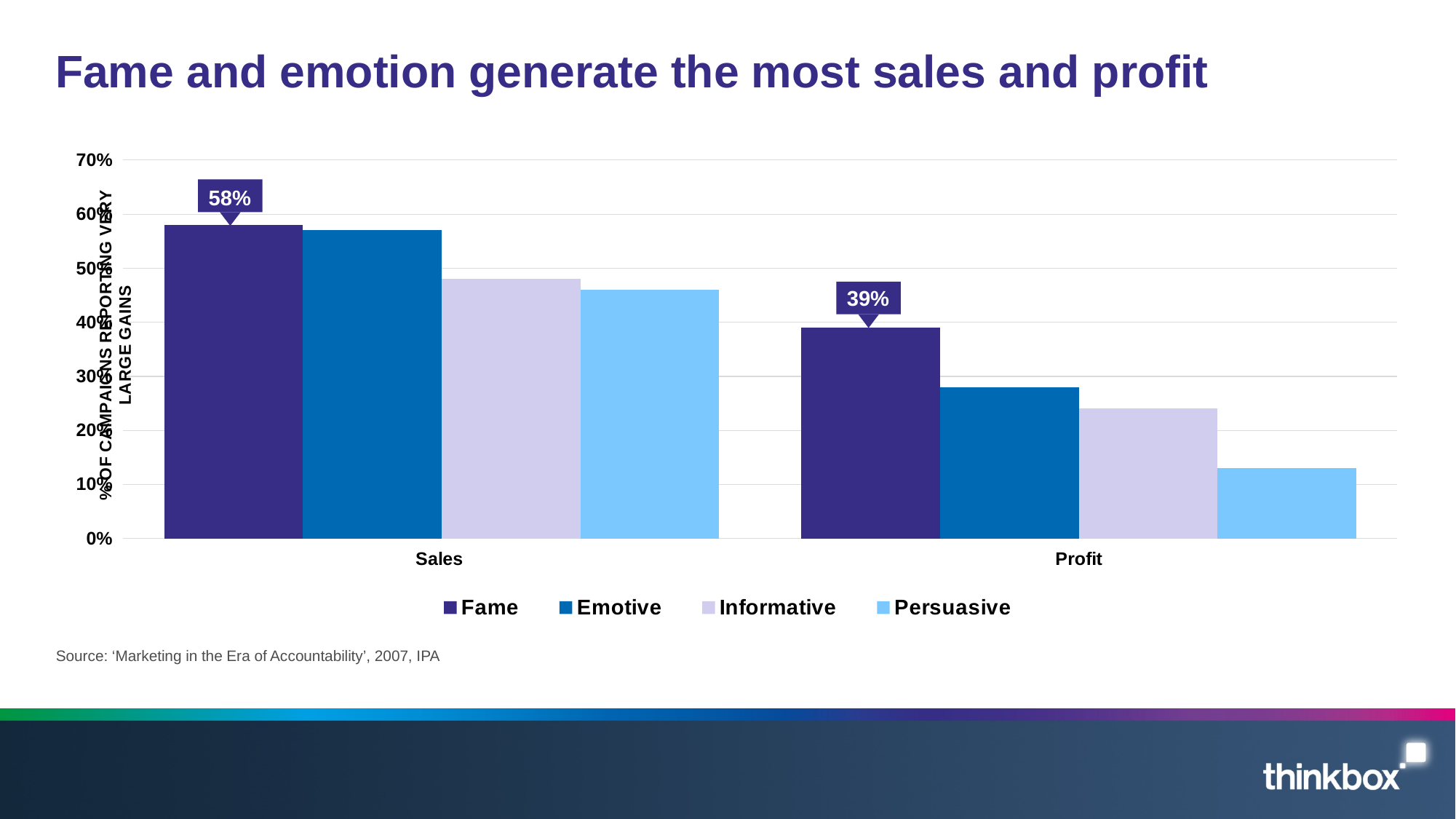
What is the difference between the Fame value for Sales and the Fame value for Profit? 19 percentage points Which series has the lowest value in the Profit category? Persuasive Which series has the highest value in the Profit category? Fame How many series does the legend list? 4 Is the value for Emotive in the Sales category greater or less than 50%? greater How many categories are shown on the x axis? 2 Is the value for Persuasive in the Profit category greater or less than 20%? less What is the value for Fame in the Sales category? 58% What is the value for Fame in the Profit category? 39% What kind of chart is shown on the slide? bar chart Is the value for Informative in the Profit category greater or less than 30%? less Is the Fame value larger for Sales or for Profit? Sales